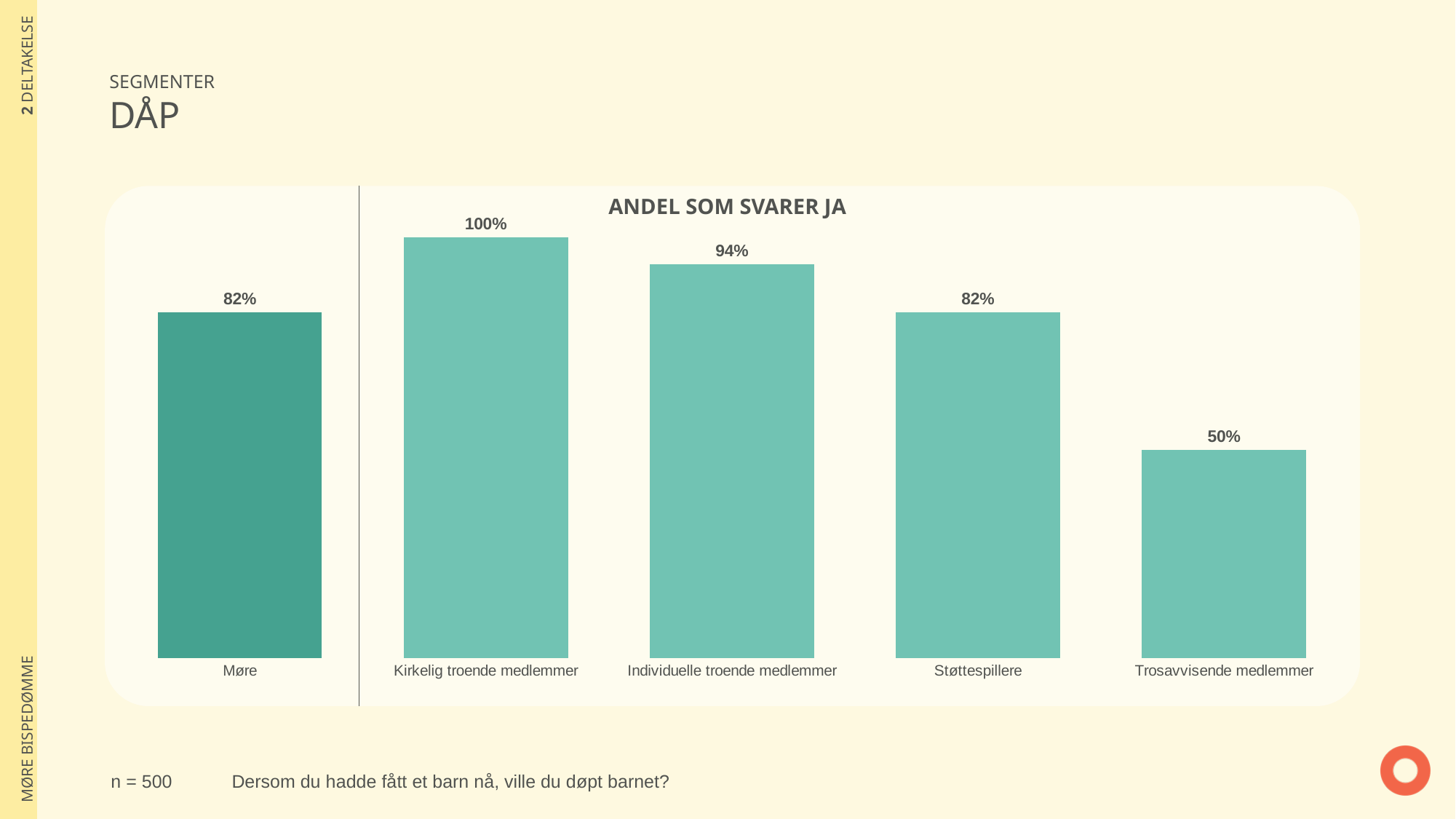
How many categories are shown in the chart? 5 What is the value for Kirkelig troende medlemmer? 100% What is the value for Individuelle troende medlemmer? 94% What is the title of the chart? ANDEL SOM SVARER JA What kind of chart is shown on the slide? Bar chart What is the difference between the values for Kirkelig troende medlemmer and Trosavvisende medlemmer? 50% What is the value for Møre? 82% Which is larger, the value for Individuelle troende medlemmer or the value for Støttespillere? Individuelle troende medlemmer Which category has the lowest value? Trosavvisende medlemmer Which category has the highest value? Kirkelig troende medlemmer What is the value for Trosavvisende medlemmer? 50% What is the difference between the values for Individuelle troende medlemmer and Støttespillere? 12%